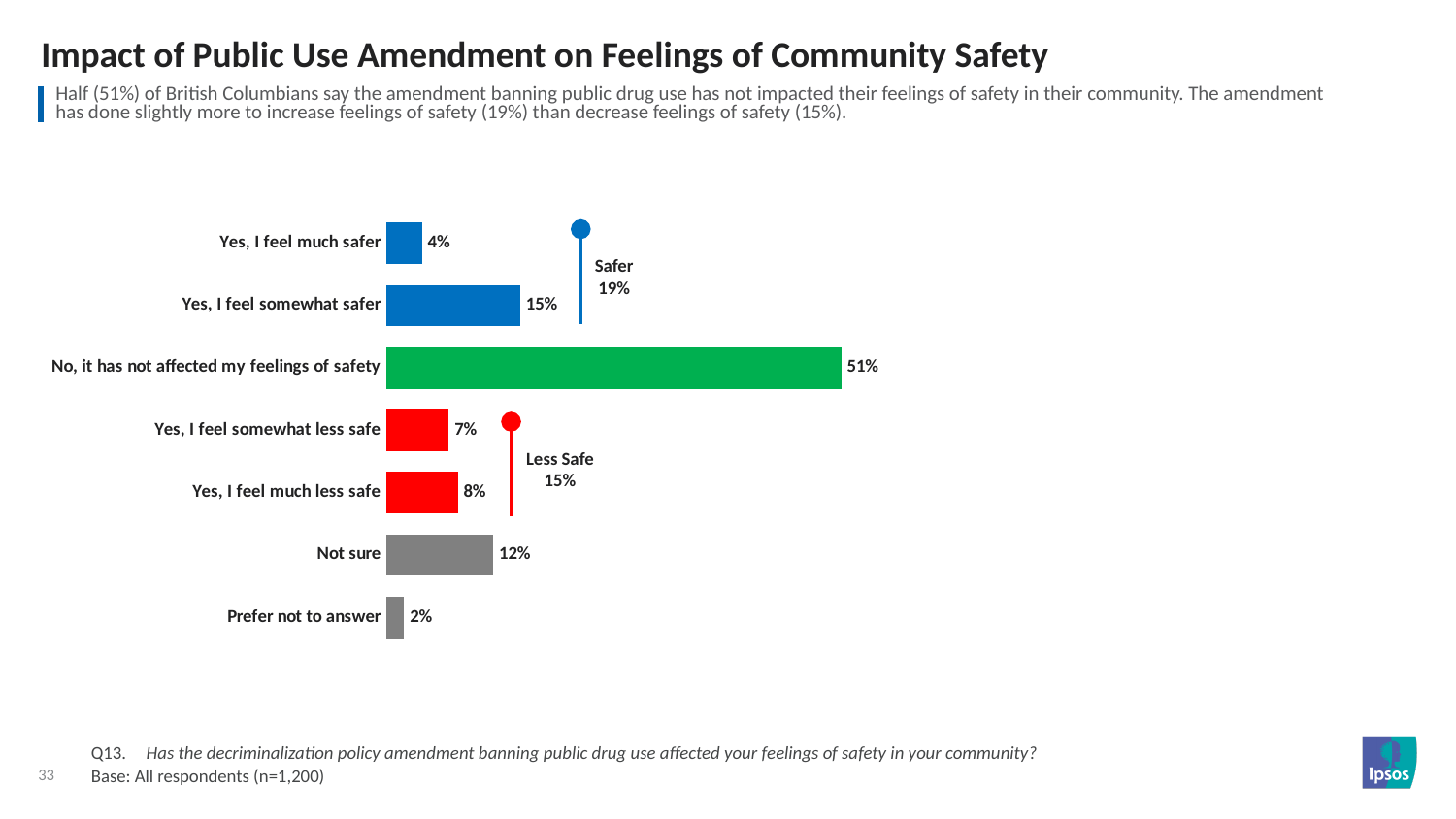
What is the value for 'Yes, I feel somewhat safer'? 15% What colour are the bars for the 'less safe' responses? Red What is the difference between 'Yes, I feel much less safe' and 'Yes, I feel much safer'? 4% How many categories are shown in the chart? 7 Which is larger: 'Yes, I feel somewhat less safe' or 'Yes, I feel much less safe'? Yes, I feel much less safe Which category has the highest value? No, it has not affected my feelings of safety What kind of chart is shown on the slide? Bar chart What percentage of respondents said the amendment has not affected their feelings of safety? 51% What is the combined 'Safer' percentage shown on the chart? 19% Which category has the lowest value? Prefer not to answer What is the value for 'Not sure'? 12% What is the value for 'Prefer not to answer'? 2%